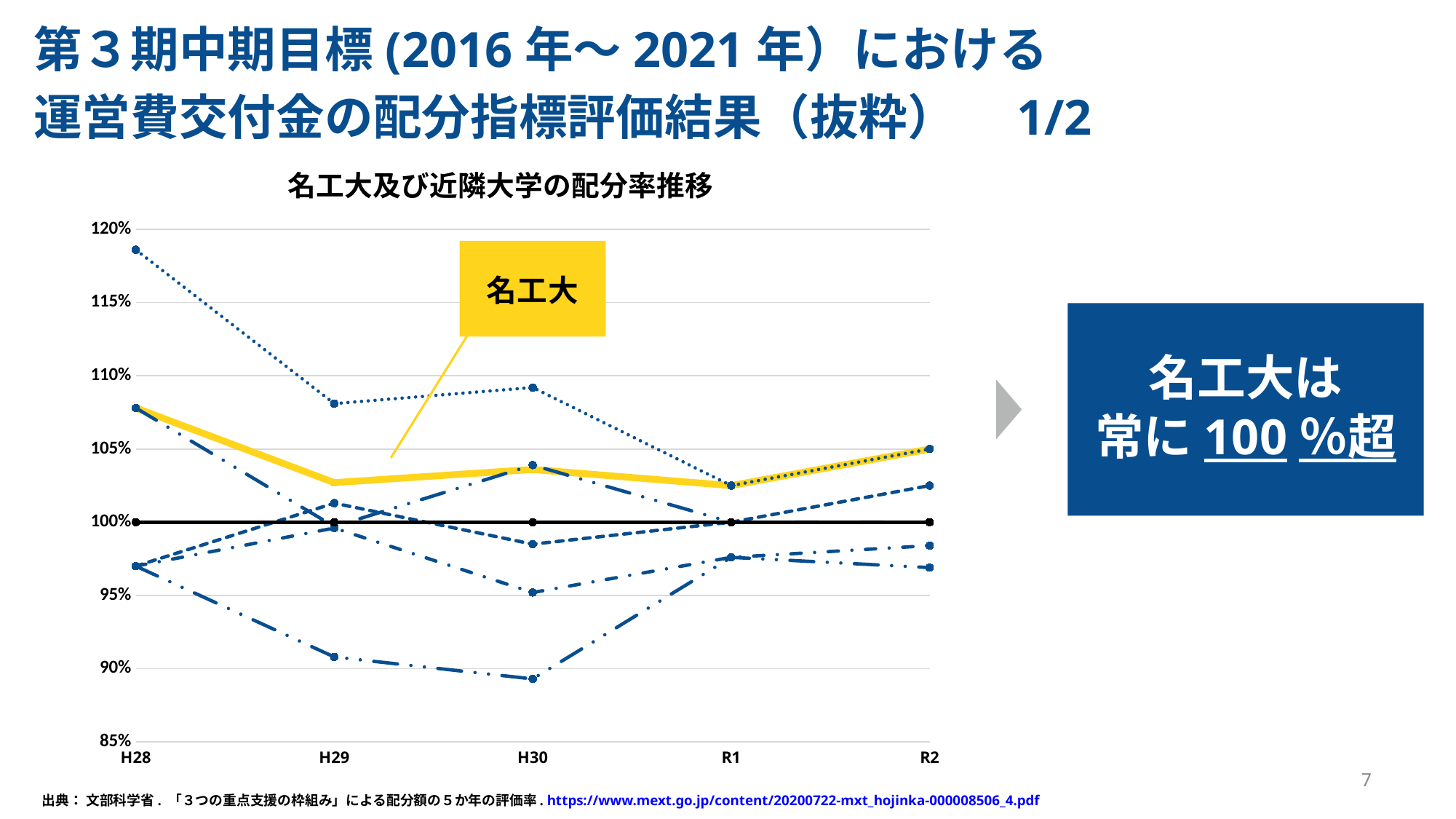
How many categories are shown on the x axis of the chart? 5 Is the highest point of the dotted line at H28 greater or less than 115%? greater At which x-axis category does the lowest point of any line in the chart occur? H30 Which line does the yellow callout label in the chart? 名工大 What kind of chart is shown on the slide? line chart Is the value for 名工大 (yellow line) at R1 greater or less than 105%? less Is the value for 名工大 (yellow line) at H29 greater or less than 100%? greater At which x-axis category does the highest point of any line in the chart occur? H28 What is the title of the chart? 名工大及び近隣大学の配分率推移 What value does the solid black horizontal line in the chart sit at? 100% Does the 名工大 (yellow) line rise or fall from H28 to H29? fall